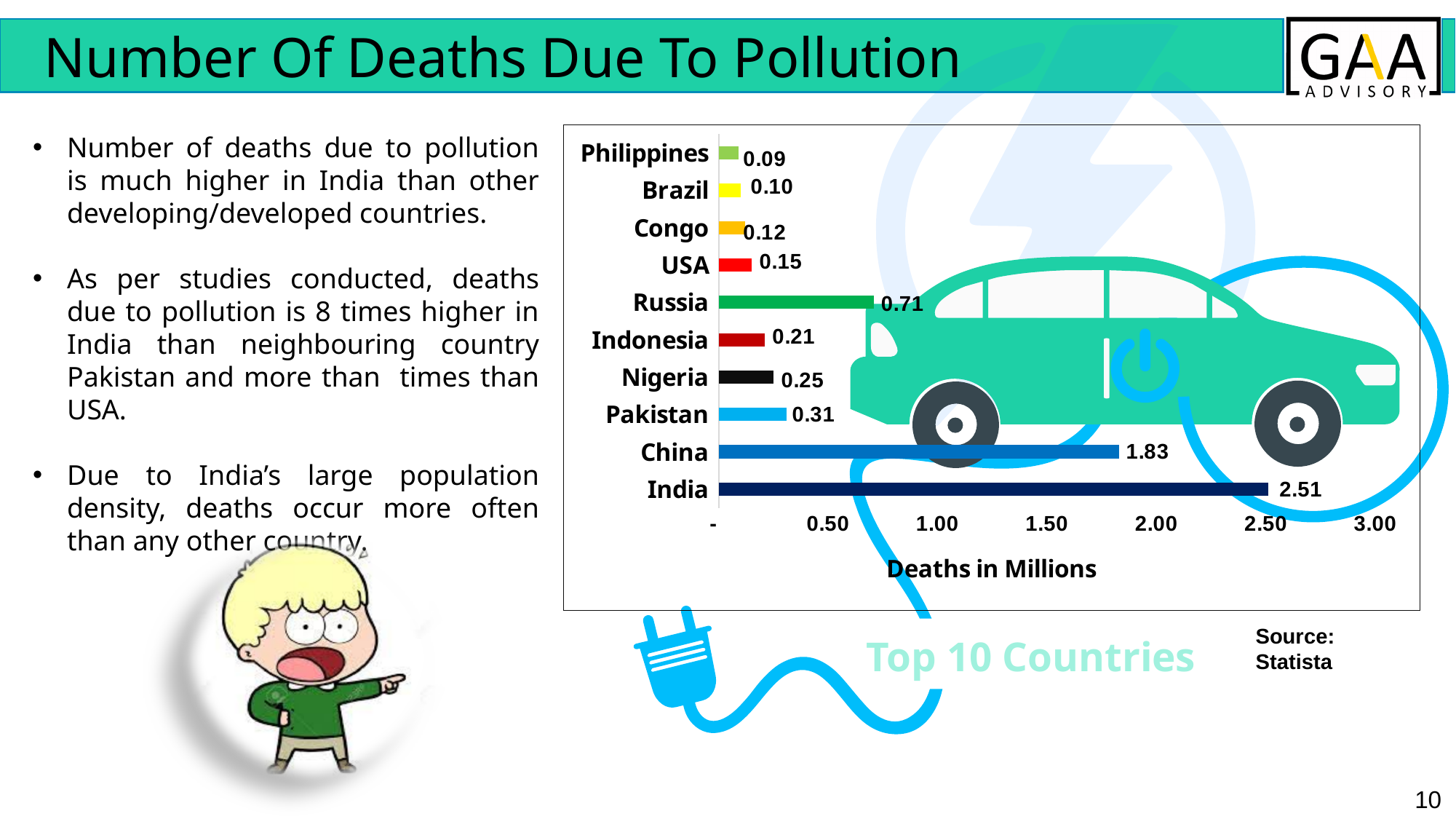
Which country has the lowest number of deaths due to pollution? Philippines What is the number of deaths in millions for India? 2.51 What is the difference in deaths (in millions) between India and China? 0.68 What is the title of the horizontal axis of the chart? Deaths in Millions Which has more deaths due to pollution, Nigeria or Indonesia? Nigeria What is the number of deaths in millions for Pakistan? 0.31 What is the number of deaths in millions for China? 1.83 How many countries are shown in the chart? 10 What is the number of deaths in millions for Russia? 0.71 Which country has the highest number of deaths due to pollution? India What type of chart is used to show deaths due to pollution? Bar chart Is the value for China greater or less than 1.50? greater